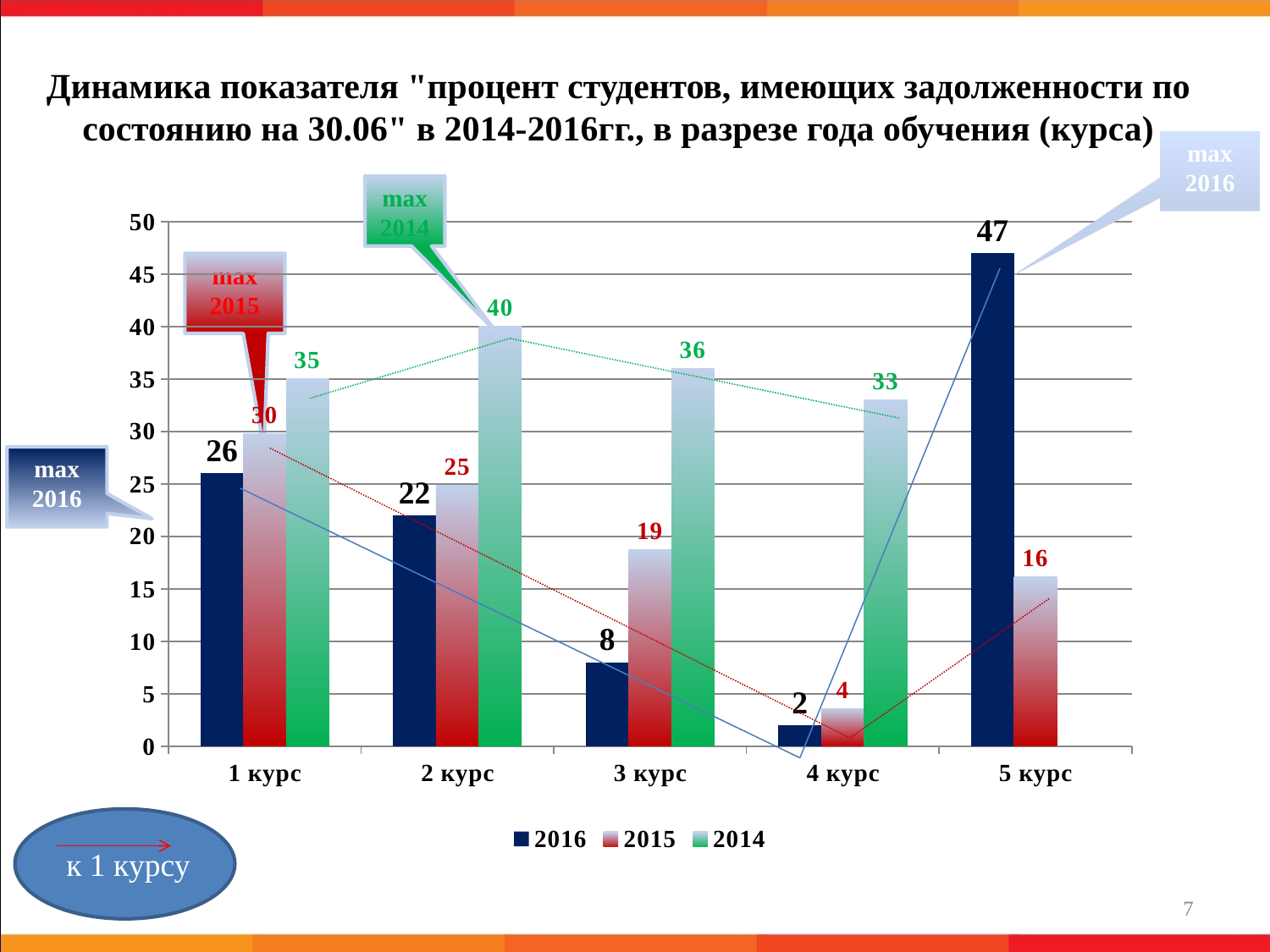
Which series is shown in green in the legend? 2014 Is the value for 2016 at 5 курс greater or less than 45? greater How many courses (categories) are shown on the x axis? 5 What is the value for 2016 at 5 курс? 47 What is the value for 2014 at 2 курс? 40 What is the value for 2015 at 3 курс? 19 How many series does the legend list? 3 Which course has the lowest value for the 2015 series? 4 курс Which is larger at 2 курс: the 2015 value or the 2014 value? 2014 What is the difference between the 2014 and 2016 values at 1 курс? 9 What kind of chart is shown on the slide? bar chart Which course has the highest value for the 2016 series? 5 курс